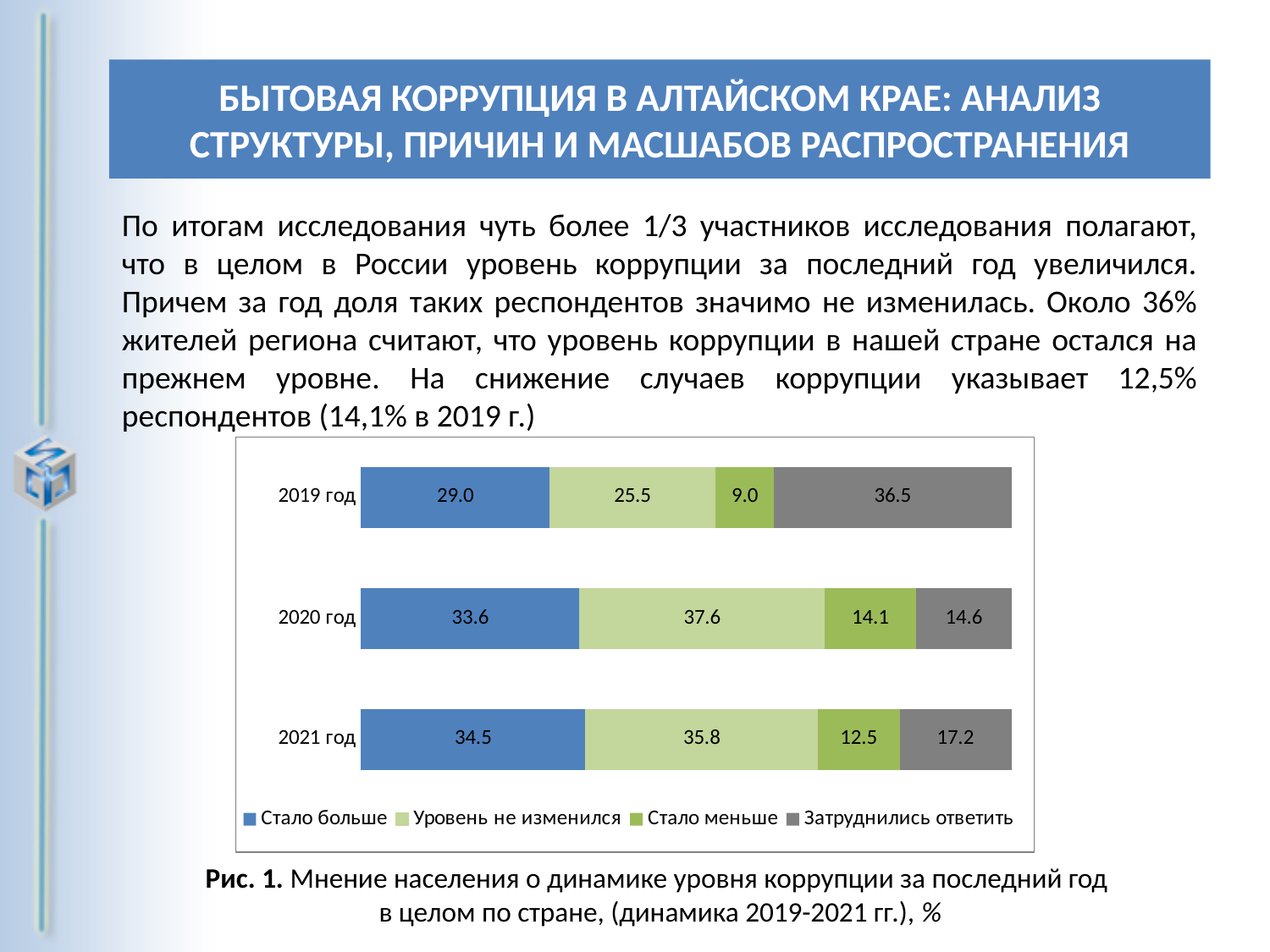
Which is larger: "Уровень не изменился" in 2020 год or in 2021 год? 2020 год What kind of chart is shown on the slide? Stacked bar chart How many years (categories) are shown in the chart? 3 What is the value for "Стало меньше" in 2021 год? 12.5 In which year is the value for "Стало меньше" the lowest? 2019 год Does the value for "Стало больше" rise or fall from 2019 год to 2021 год? Rise What is the difference between the "Стало больше" values for 2021 год and 2019 год? 5.5 What is the value for "Стало больше" in 2019 год? 29.0 What is the value for "Уровень не изменился" in 2020 год? 37.6 What is the value for "Затруднились ответить" in 2021 год? 17.2 How many series does the legend list? 4 In which year is the value for "Затруднились ответить" the highest? 2019 год